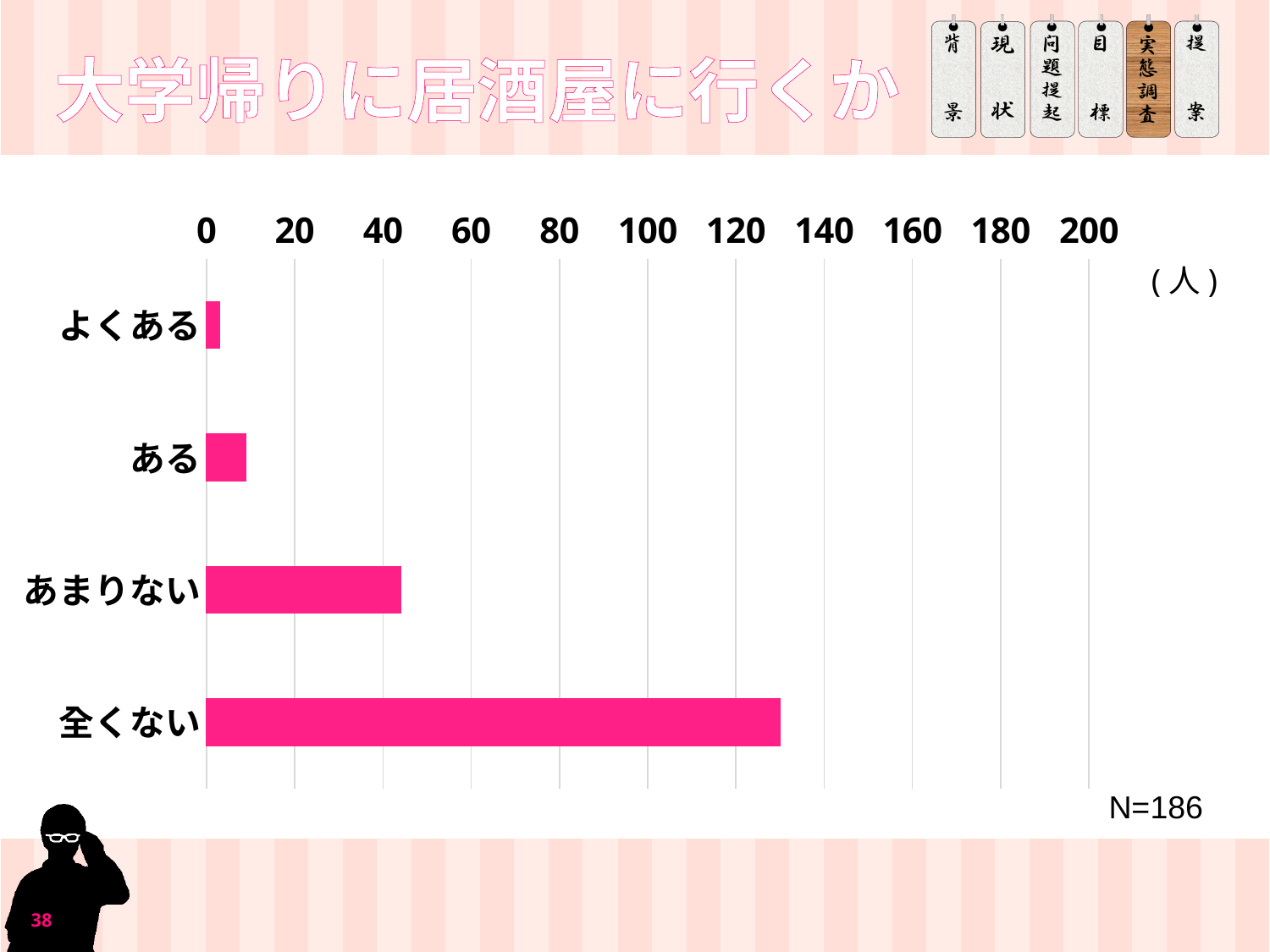
Which category has the highest value? 全くない Which category has the lowest value? よくある Is the value for 全くない greater or less than 140? less Which is larger, the value for あまりない or the value for ある? あまりない What kind of chart is shown on the slide? bar chart How many categories does the chart show? 4 Is the value for あまりない greater or less than 60? less What is the title of the slide containing the chart? 大学帰りに居酒屋に行くか Is the value for 全くない greater or less than 120? greater What sample size (N) is shown below the chart? N=186